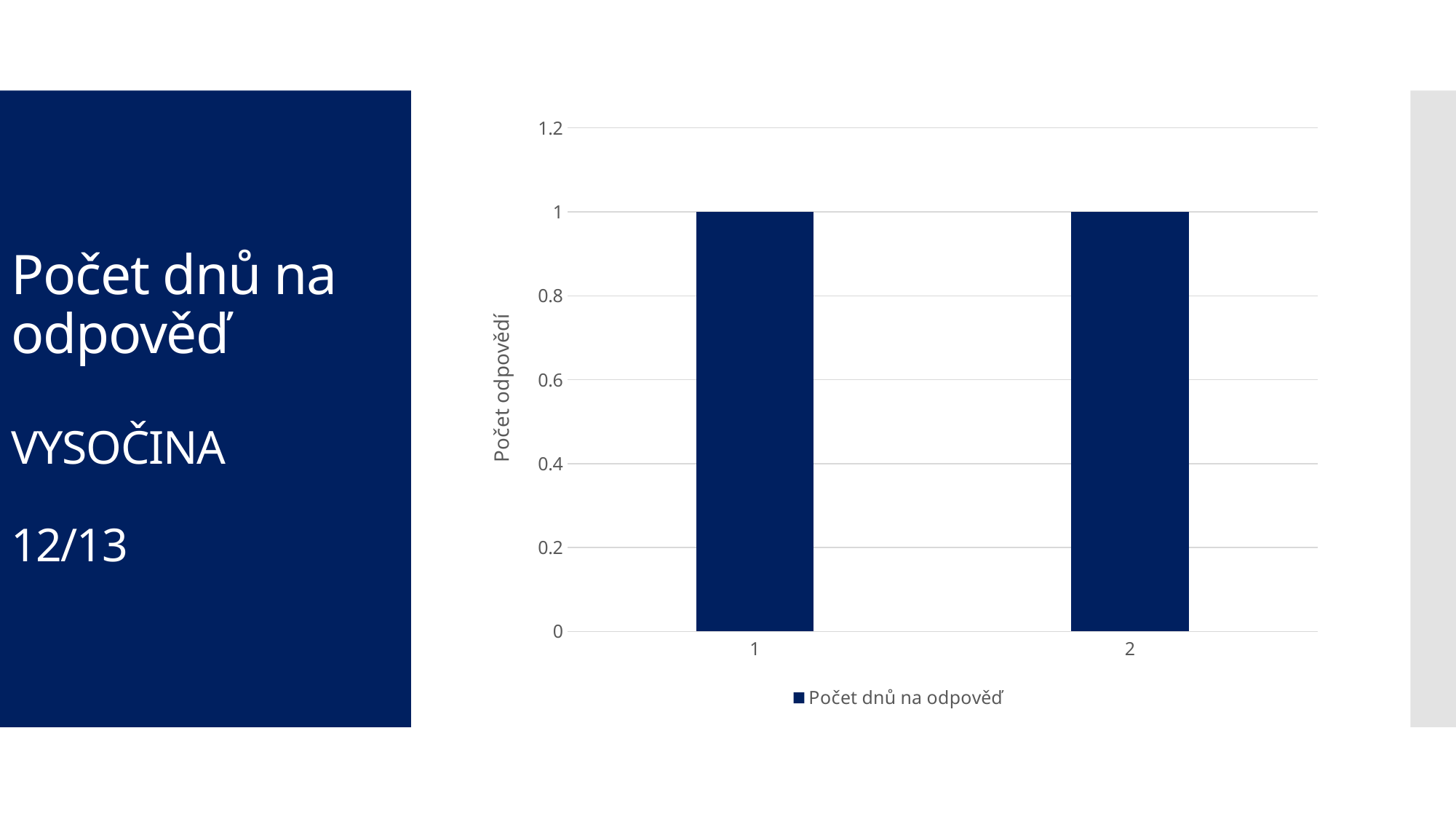
Do the values rise, fall or stay the same from category 1 to category 2? stay the same What is the label of the series in the chart legend? Počet dnů na odpověď What type of chart is shown on the slide? bar chart How many categories are shown on the x axis of the chart? 2 Is the value for category 1 greater or less than 0.8? greater What is the difference between the values for category 1 and category 2? 0 What is the value for category 2 in the chart? 1 Is the value for category 2 greater or less than 1.2? less What is the value for category 1 in the chart? 1 What is the label on the vertical axis of the chart? Počet odpovědí How many series does the chart legend list? 1